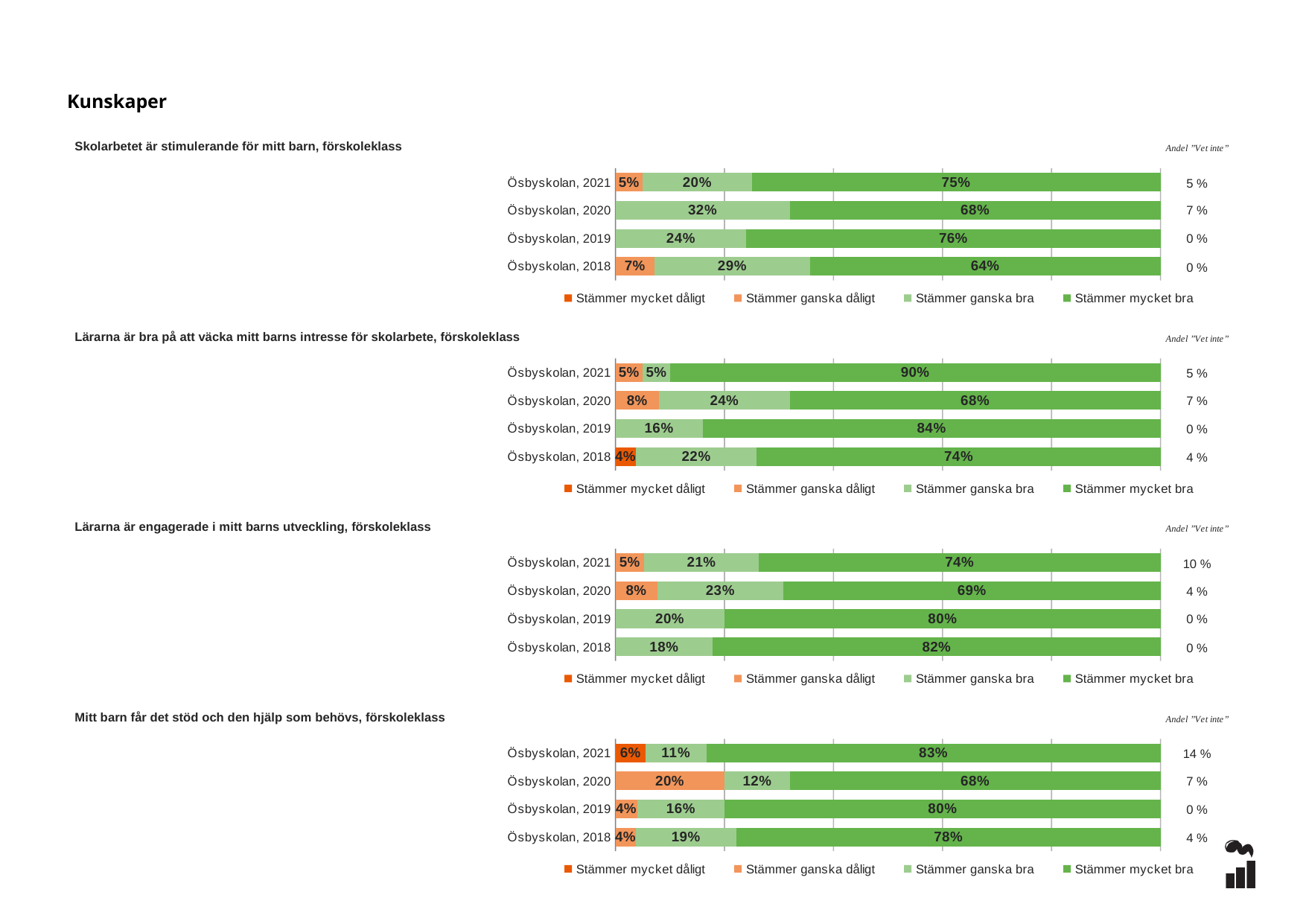
In the chart 'Skolarbetet är stimulerande för mitt barn, förskoleklass', what is the difference between the 'Stämmer ganska bra' values for Ösbyskolan, 2020 and Ösbyskolan, 2019? 8% How many series does the legend list in the chart 'Mitt barn får det stöd och den hjälp som behövs, förskoleklass'? 4 In the chart 'Skolarbetet är stimulerande för mitt barn, förskoleklass', what is the 'Stämmer mycket bra' value for Ösbyskolan, 2021? 75% In the chart 'Mitt barn får det stöd och den hjälp som behövs, förskoleklass', what is the 'Stämmer ganska dåligt' value for Ösbyskolan, 2020? 20% In the chart 'Lärarna är bra på att väcka mitt barns intresse för skolarbete, förskoleklass', which year has the lowest 'Stämmer mycket bra' value? Ösbyskolan, 2020 In the chart 'Lärarna är engagerade i mitt barns utveckling, förskoleklass', is the 'Stämmer mycket bra' value for Ösbyskolan, 2018 larger or smaller than for Ösbyskolan, 2019? larger In the chart 'Lärarna är bra på att väcka mitt barns intresse för skolarbete, förskoleklass', what is the 'Stämmer mycket bra' value for Ösbyskolan, 2021? 90% In the chart 'Lärarna är engagerade i mitt barns utveckling, förskoleklass', what is the 'Stämmer ganska dåligt' value for Ösbyskolan, 2020? 8% What kind of chart is 'Skolarbetet är stimulerande för mitt barn, förskoleklass'? Stacked bar chart In the chart 'Skolarbetet är stimulerande för mitt barn, förskoleklass', which year has the highest 'Stämmer mycket bra' value? Ösbyskolan, 2019 In the chart 'Mitt barn får det stöd och den hjälp som behövs, förskoleklass', what is the 'Andel Vet inte' value shown for Ösbyskolan, 2021? 14 % In the chart 'Lärarna är bra på att väcka mitt barns intresse för skolarbete, förskoleklass', what is the 'Stämmer mycket dåligt' value for Ösbyskolan, 2018? 4%